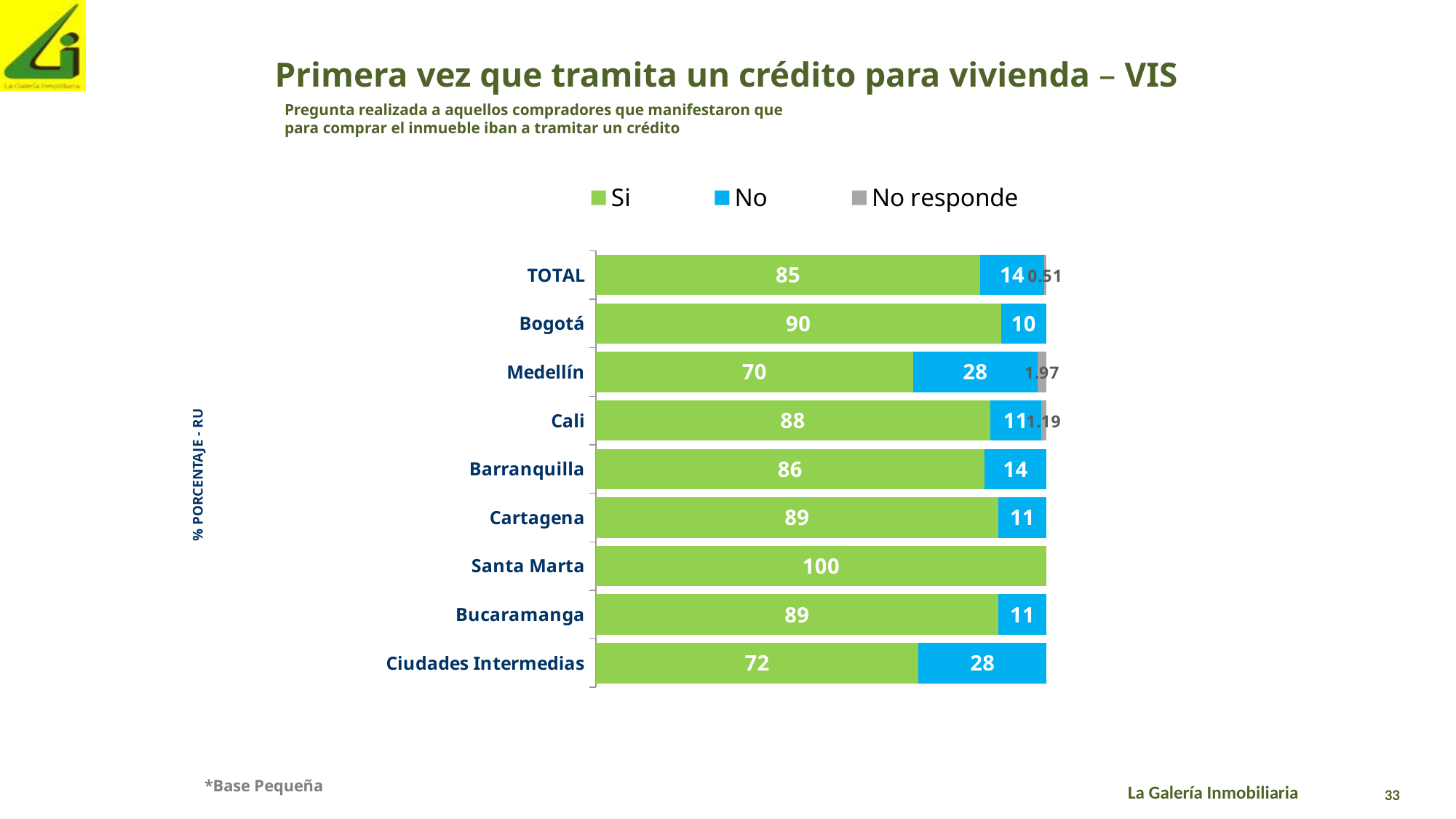
How many series does the legend list? 3 What kind of chart is shown on the slide? Stacked bar chart What is the 'No responde' value for Cali? 1.19 Which series is shown in green in the legend? Si Which category has the lowest 'Si' value? Medellín Which category has the highest 'Si' value? Santa Marta What is the difference between the 'Si' values for Bogotá and Ciudades Intermedias? 18 Which is larger, the 'No' value for Barranquilla or the 'No' value for Cartagena? Barranquilla How many categories are shown on the chart? 9 What is the 'Si' value for Bogotá? 90 What is the 'No' value for Medellín? 28 What is the 'No responde' value for TOTAL? 0.51